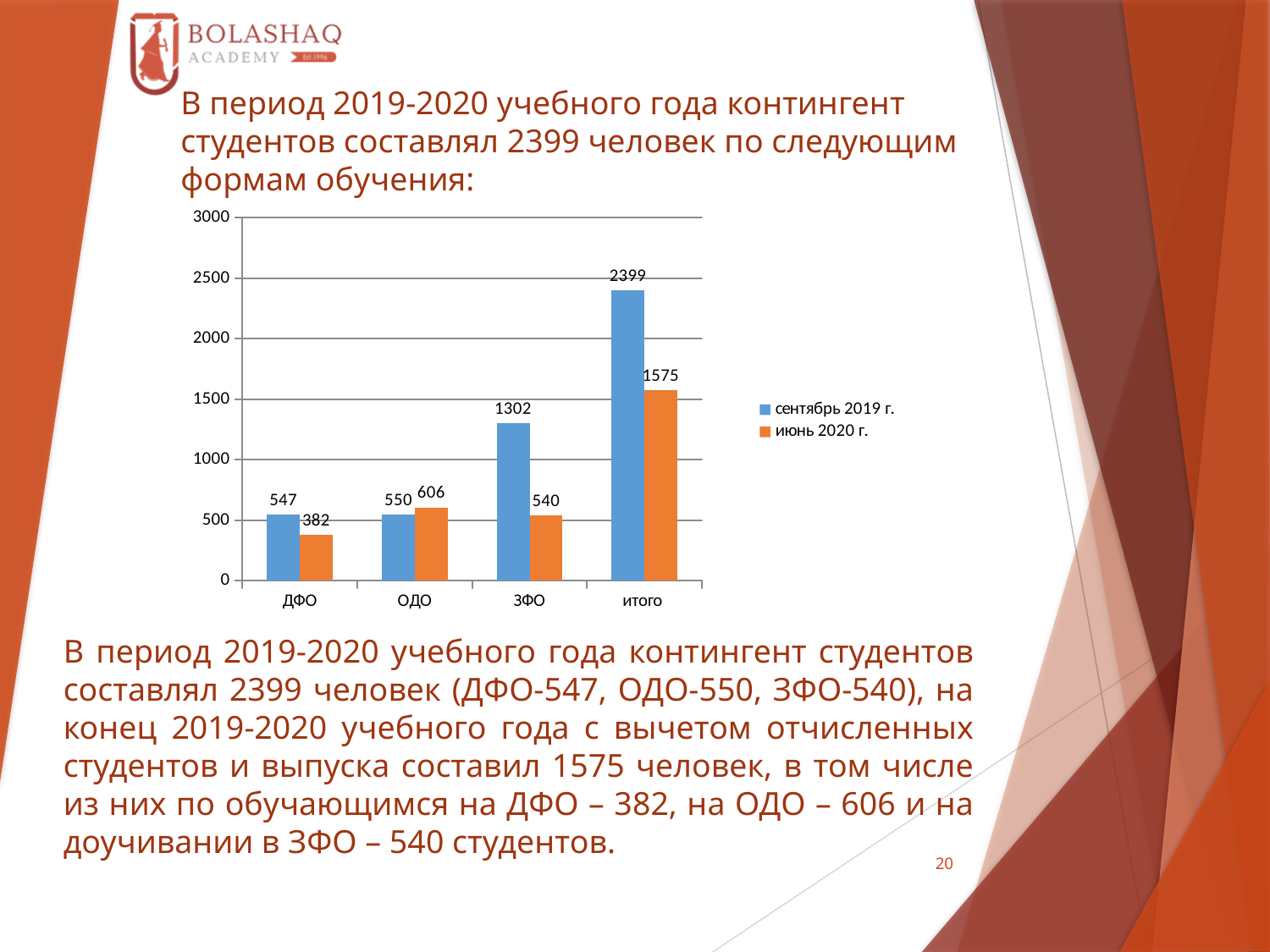
How many categories are shown on the x axis? 4 What is the difference between the сентябрь 2019 г. and июнь 2020 г. values for итого? 824 What is the value for итого in the июнь 2020 г. series? 1575 For ОДО, which series has the larger value: сентябрь 2019 г. or июнь 2020 г.? июнь 2020 г. What is the value for ОДО in the июнь 2020 г. series? 606 What kind of chart is shown on the slide? bar chart Which category has the lowest value in the июнь 2020 г. series? ДФО What is the value for ДФО in the сентябрь 2019 г. series? 547 What is the value for ЗФО in the сентябрь 2019 г. series? 1302 How many series does the legend list? 2 What colour are the bars for the июнь 2020 г. series? orange What is the difference between the сентябрь 2019 г. and июнь 2020 г. values for ЗФО? 762